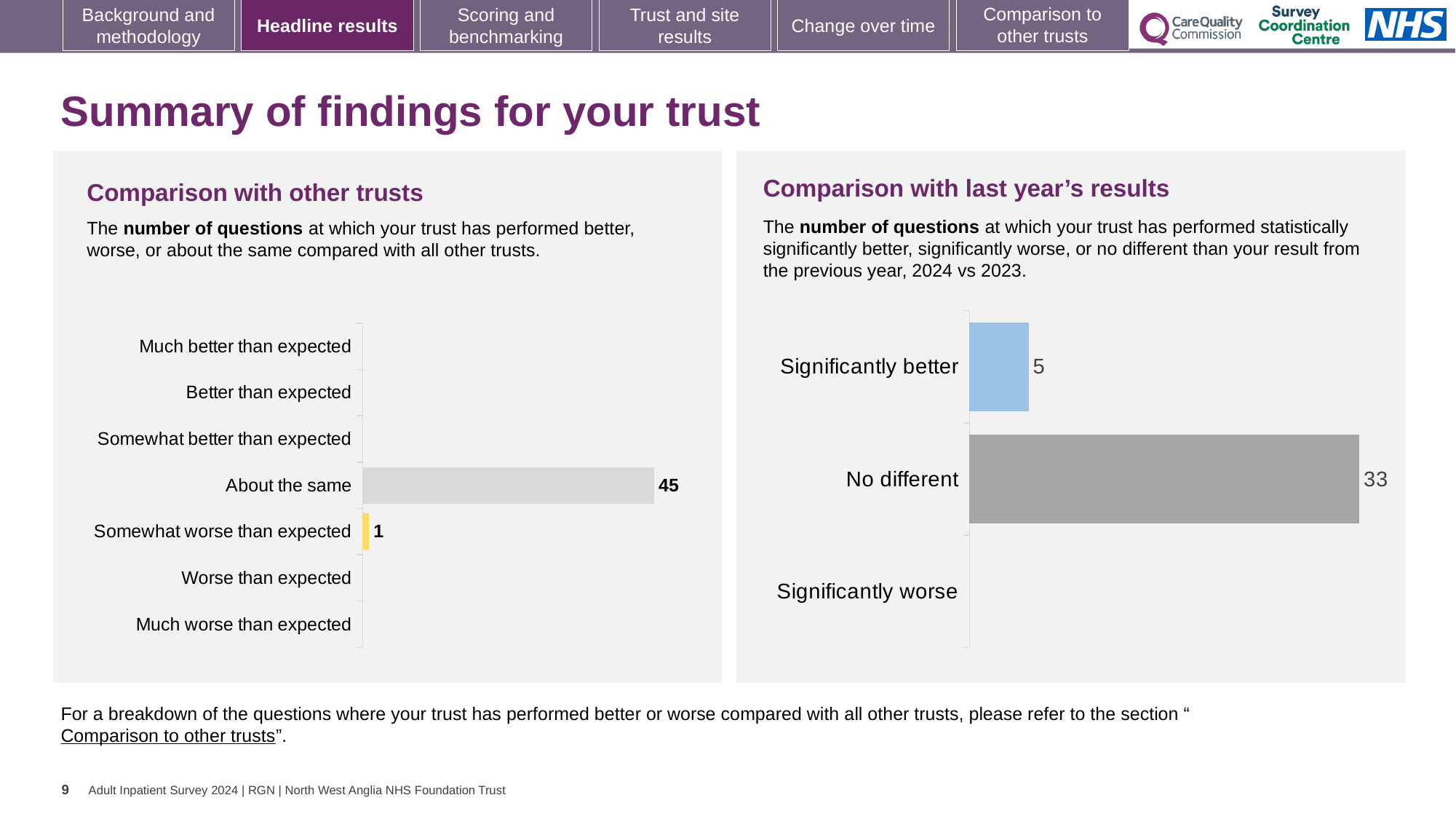
In the 'Comparison with last year's results' chart, what is the difference between 'No different' and 'Significantly better'? 28 In the 'Comparison with other trusts' chart, what is the difference between 'About the same' and 'Somewhat worse than expected'? 44 In the 'Comparison with last year's results' chart, what colour is the 'Significantly better' bar? Light blue In the 'Comparison with last year's results' chart, how many questions are 'No different'? 33 In the 'Comparison with last year's results' chart, how many categories are shown? 3 In the 'Comparison with other trusts' chart, how many categories are listed on the vertical axis? 7 What type of chart is the 'Comparison with other trusts' chart? Bar chart In the 'Comparison with last year's results' chart, which category has the highest value? No different In the 'Comparison with last year's results' chart, how many questions are 'Significantly better'? 5 In the 'Comparison with other trusts' chart, how many questions are 'About the same'? 45 In the 'Comparison with other trusts' chart, which category has the highest value? About the same In the 'Comparison with other trusts' chart, how many questions are 'Somewhat worse than expected'? 1